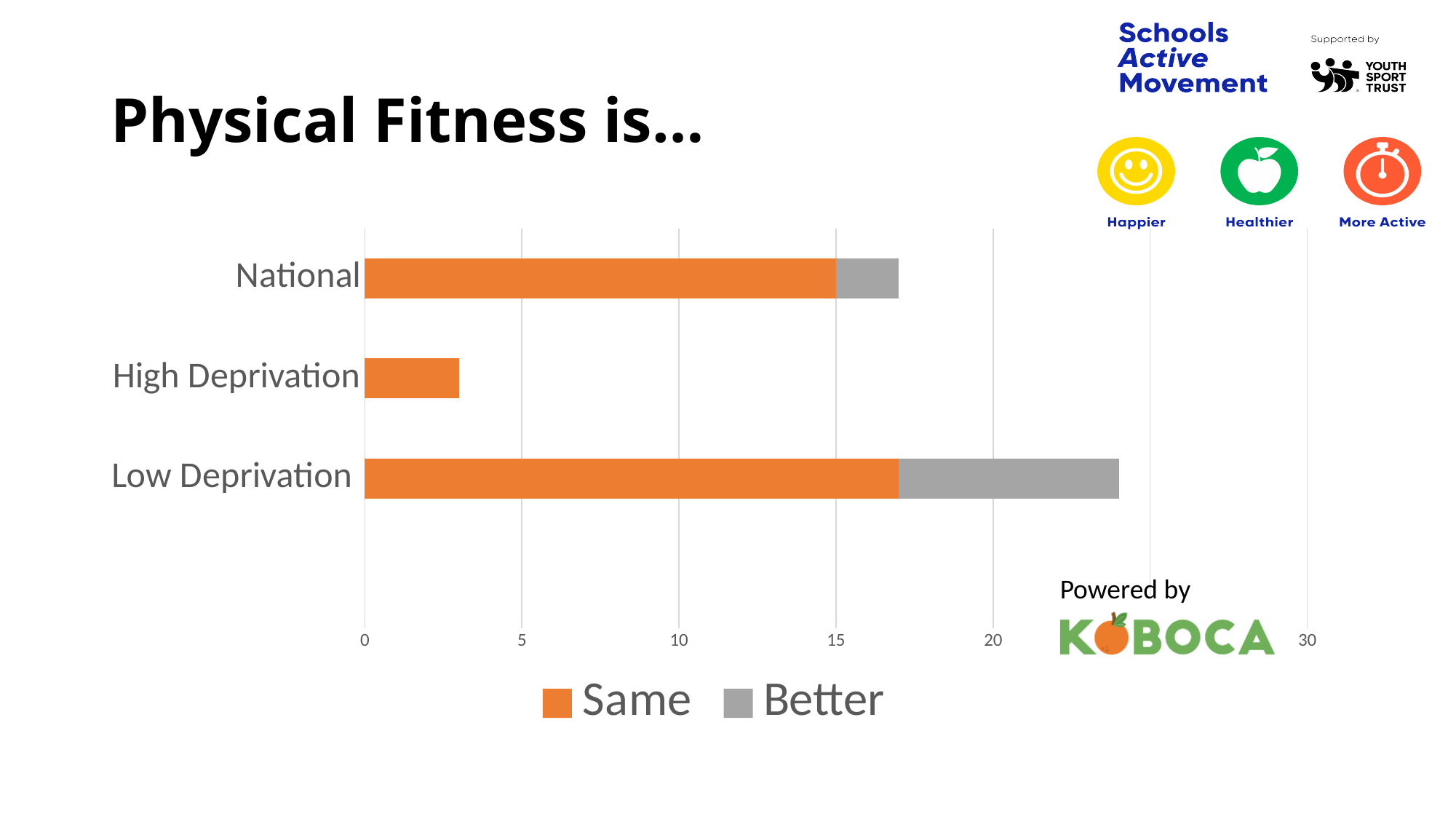
Which colour represents the Same series in the chart? orange What is the value of the Same series for National? 15 What kind of chart is shown on the slide? bar chart Is the Same value for Low Deprivation greater or less than 15? greater How many series does the legend list? 2 Which is larger, the Same value for National or the Same value for High Deprivation? National Which category has the shortest total bar? High Deprivation How many categories are shown on the chart? 3 Which is larger, the Better value for Low Deprivation or the Better value for National? Low Deprivation Is the Same value for High Deprivation greater or less than 5? less Is the total bar for Low Deprivation greater or less than 20? greater Which category has the longest total bar? Low Deprivation